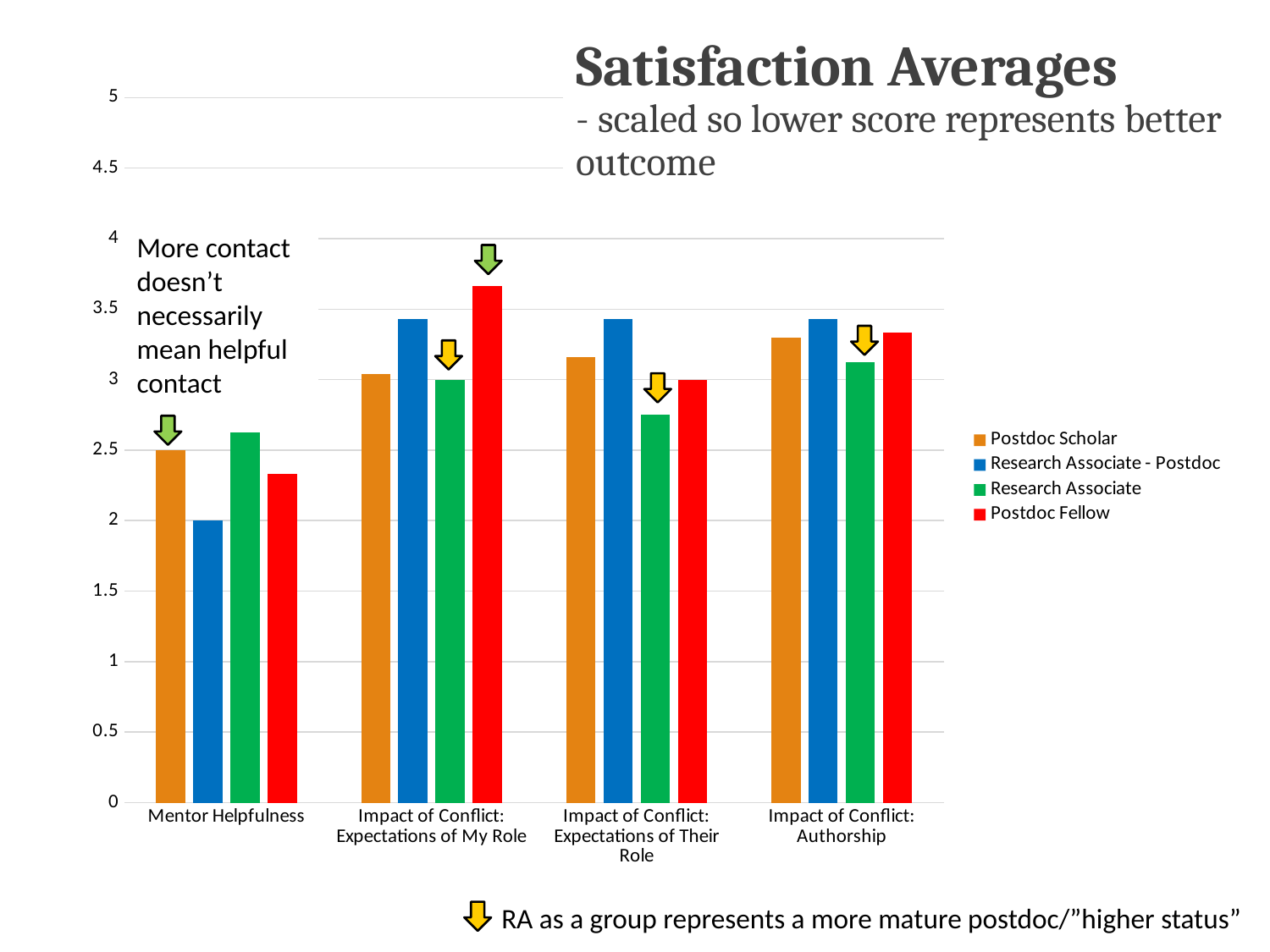
What is the value for Research Associate - Postdoc in the Mentor Helpfulness category? 2 Which series has the lowest value in the Impact of Conflict: Expectations of Their Role category? Research Associate What is the title of the chart? Satisfaction Averages Is the value for Postdoc Fellow in the Impact of Conflict: Expectations of My Role category greater or less than 3.5? greater How many categories are shown along the x axis? 4 In the Mentor Helpfulness category, which is larger: Research Associate or Postdoc Fellow? Research Associate Is the value for Postdoc Scholar in the Impact of Conflict: Authorship category greater or less than 3? greater Is the value for Research Associate in the Impact of Conflict: Expectations of Their Role category greater or less than 3? less How many series does the legend list? 4 Which series has the highest value in the Impact of Conflict: Expectations of My Role category? Postdoc Fellow Which series has the lowest value in the Mentor Helpfulness category? Research Associate - Postdoc What kind of chart is shown on the slide? bar chart